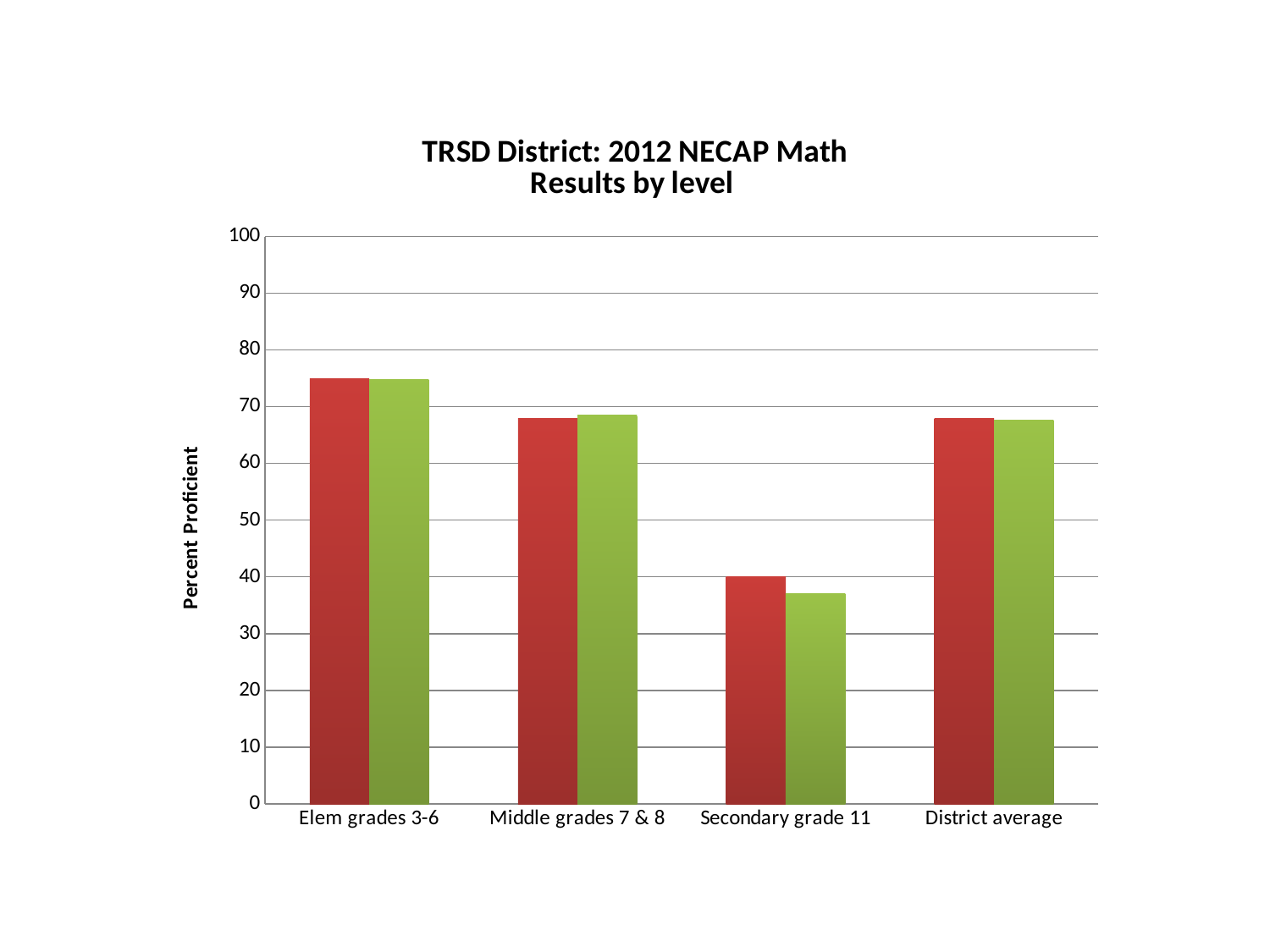
What kind of chart is shown on the slide? bar chart What is the label on the vertical axis? Percent Proficient Which is larger, the green bar for Elem grades 3-6 or the green bar for Secondary grade 11? Elem grades 3-6 Which category has the highest red bar? Elem grades 3-6 For Secondary grade 11, which bar is taller, the red one or the green one? the red one Which category has the lowest green bar? Secondary grade 11 How many categories are shown along the x axis? 4 Is the red bar for Middle grades 7 & 8 greater or less than 60? greater Is the red bar for Elem grades 3-6 greater or less than 70? greater What is the title of the chart? TRSD District: 2012 NECAP Math Results by level Is the green bar for District average greater or less than 70? less